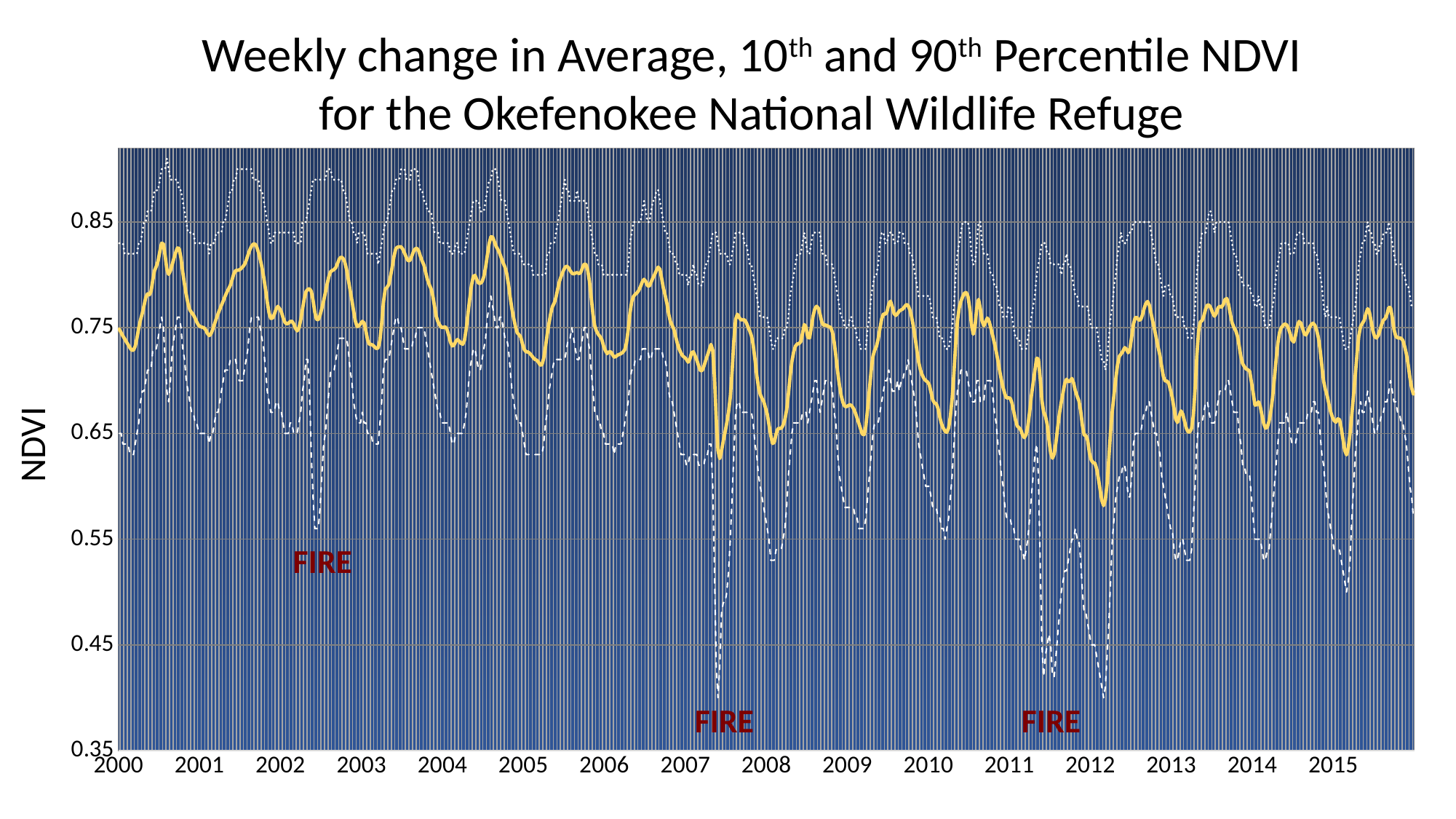
Is the lowest point of the lower dashed line around 2007 greater or less than 0.45? less How many year labels are shown along the x axis? 16 Is the peak of the solid yellow average line higher in 2000 or in 2012? 2000 Is the highest point of the upper dotted line in 2000 greater or less than 0.85? greater What is the title of the chart? Weekly change in Average, 10th and 90th Percentile NDVI for the Okefenokee National Wildlife Refuge Is the lowest point of the solid yellow average line in 2012 greater or less than 0.65? less What is the lowest value labelled on the y axis? 0.35 What kind of chart is shown on the slide? Line chart What is the highest value labelled on the y axis? 0.85 How many times does the word FIRE appear on the chart? 3